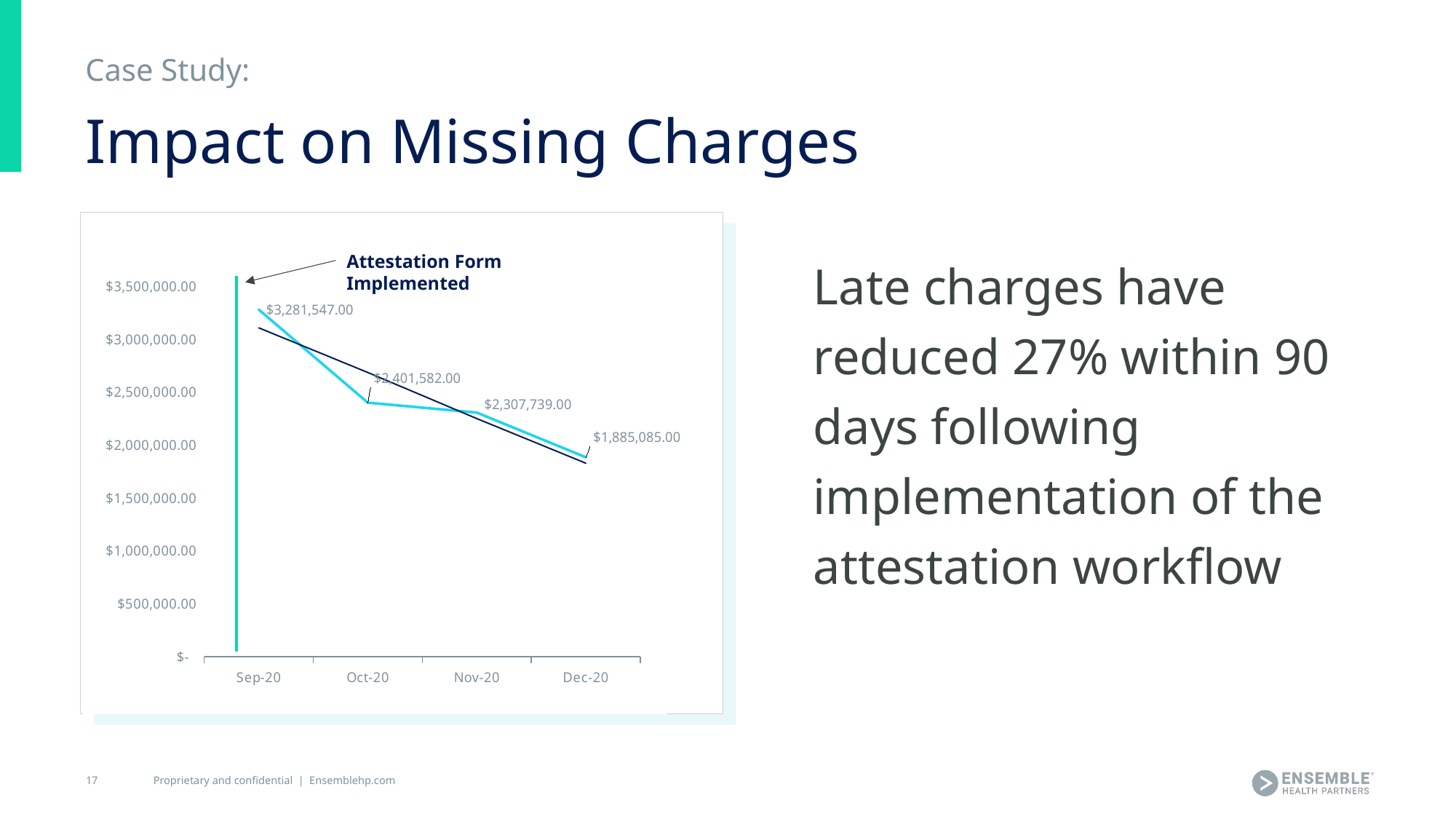
What is the difference between the Sep-20 and Dec-20 values? $1,396,462.00 What is the difference between the Oct-20 and Nov-20 values? $93,843.00 How many months are plotted on the x axis? 4 Which month has the lowest value? Dec-20 What is the value for Oct-20? $2,401,582.00 Which is larger, the value for Oct-20 or the value for Dec-20? Oct-20 Which month has the highest value? Sep-20 Do the values rise or fall from Sep-20 to Dec-20? Fall What is the value for Nov-20? $2,307,739.00 What is the value for Sep-20? $3,281,547.00 What is the value for Dec-20? $1,885,085.00 What kind of chart is shown? Line chart